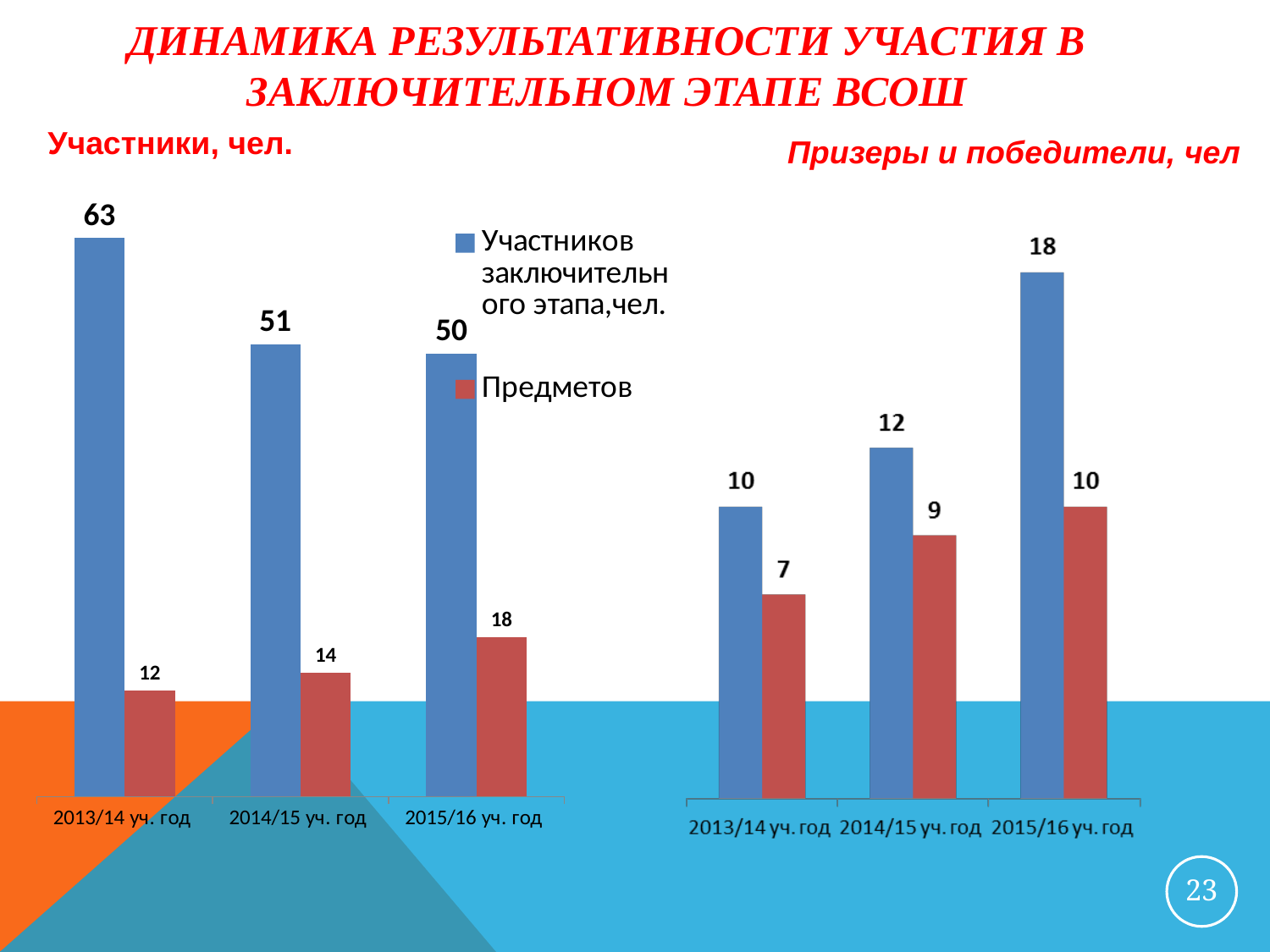
In the left chart (Участники, чел.), how many series does the legend list? 2 What kind of chart is the right chart (Призеры и победители, чел)? bar chart In the right chart (Призеры и победители, чел), what is the value of the blue bar for 2015/16 уч. год? 18 In the left chart (Участники, чел.), does the Предметов series rise or fall from 2013/14 уч. год to 2015/16 уч. год? rise In the left chart (Участники, чел.), what is the value for Участников заключительного этапа in 2013/14 уч. год? 63 In the right chart (Призеры и победители, чел), what is the value of the red bar for 2013/14 уч. год? 7 In the left chart (Участники, чел.), what is the difference between the Участников заключительного этапа values for 2013/14 уч. год and 2014/15 уч. год? 12 In the right chart (Призеры и победители, чел), how many years are shown on the x axis? 3 In the right chart (Призеры и победители, чел), what is the difference between the blue and red bars for 2014/15 уч. год? 3 In the left chart (Участники, чел.), which year has the lowest value for Предметов? 2013/14 уч. год In the left chart (Участники, чел.), what is the value for Предметов in 2015/16 уч. год? 18 In the left chart (Участники, чел.), which year has the highest value for Участников заключительного этапа? 2013/14 уч. год